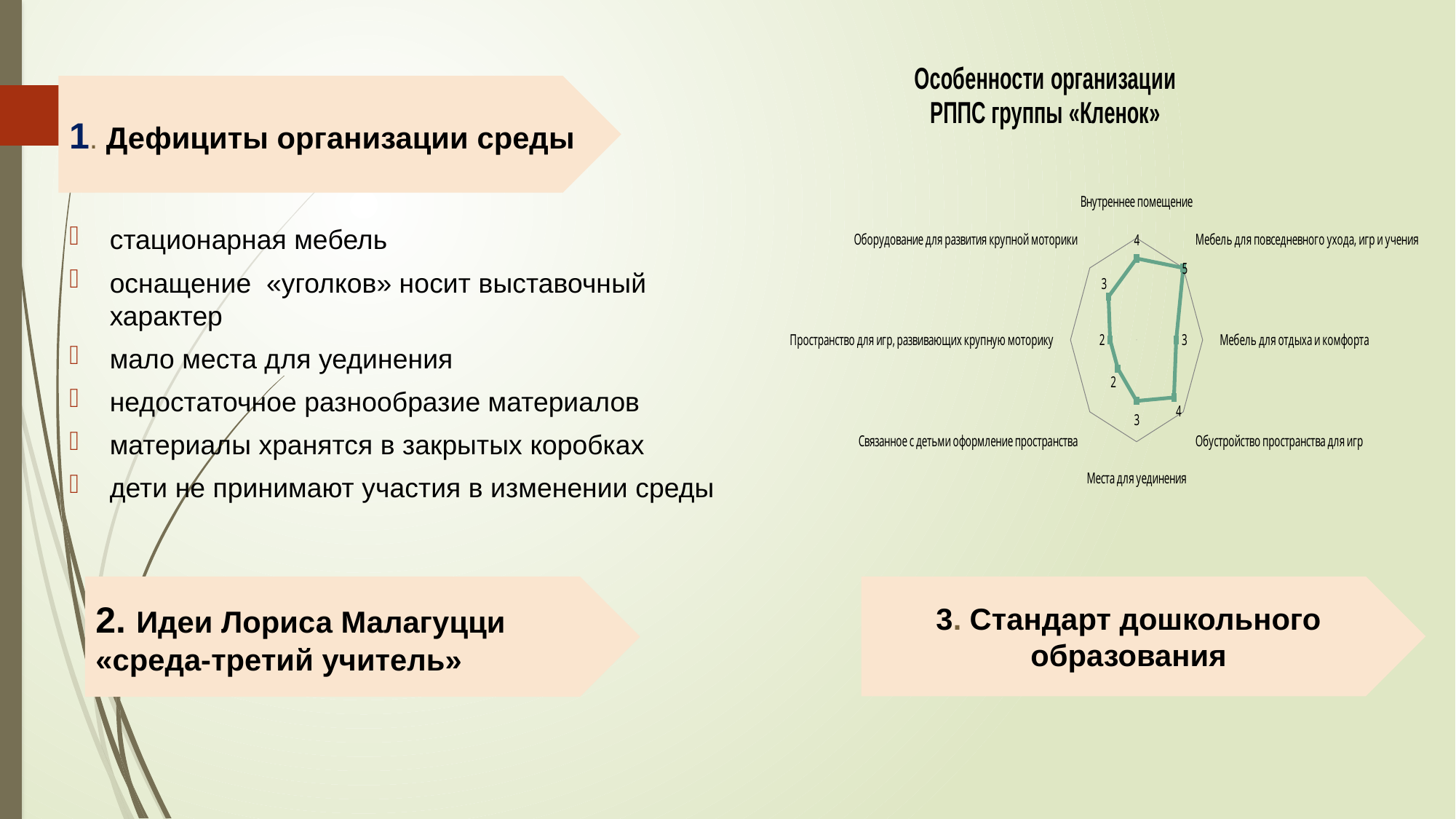
What is the title of the chart? Особенности организации РППС группы «Кленок» How many categories does the radar chart have? 8 Which category has the highest value? Мебель для повседневного ухода, игр и учения What is the value for «Мебель для отдыха и комфорта»? 3 What is the value for «Обустройство пространства для игр»? 4 What is the value for «Связанное с детьми оформление пространства»? 2 What is the value for «Мебель для повседневного ухода, игр и учения»? 5 What is the difference between the values for «Мебель для повседневного ухода, игр и учения» and «Пространство для игр, развивающих крупную моторику»? 3 What is the value for «Места для уединения»? 3 What type of chart is shown on the slide? Radar chart Which is larger: the value for «Обустройство пространства для игр» or the value for «Оборудование для развития крупной моторики»? Обустройство пространства для игр What is the value for «Внутреннее помещение»? 4